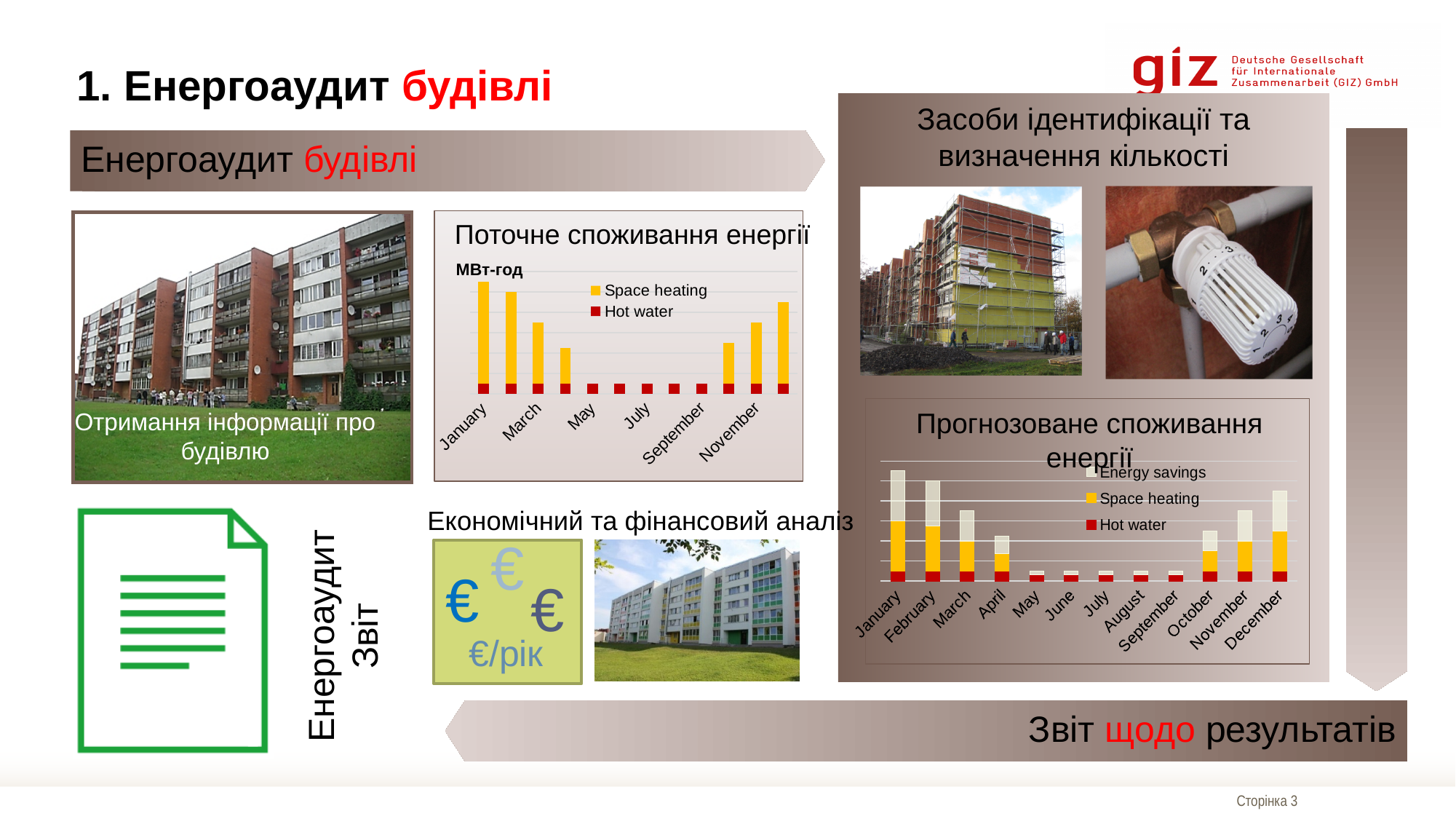
What kind of chart is the 'Прогнозоване споживання енергії' chart? bar chart In the 'Поточне споживання енергії' chart, which month has the highest Space heating value? January What kind of chart is the 'Поточне споживання енергії' chart? bar chart In the 'Прогнозоване споживання енергії' chart, do the stacked bar heights rise or fall from September to December? rise In the 'Поточне споживання енергії' chart, what unit is shown on the vertical axis label? МВт-год How many series does the legend of the 'Прогнозоване споживання енергії' chart list? 3 In the 'Прогнозоване споживання енергії' chart, which month has the tallest stacked bar? January How many months are shown on the x axis of the 'Прогнозоване споживання енергії' chart? 12 In the 'Поточне споживання енергії' chart, do the Space heating values rise or fall from January to May? fall In the 'Прогнозоване споживання енергії' chart, is the stacked bar for December taller or shorter than the bar for November? taller How many series does the legend of the 'Поточне споживання енергії' chart list? 2 In the 'Поточне споживання енергії' chart, which series is shown in red? Hot water